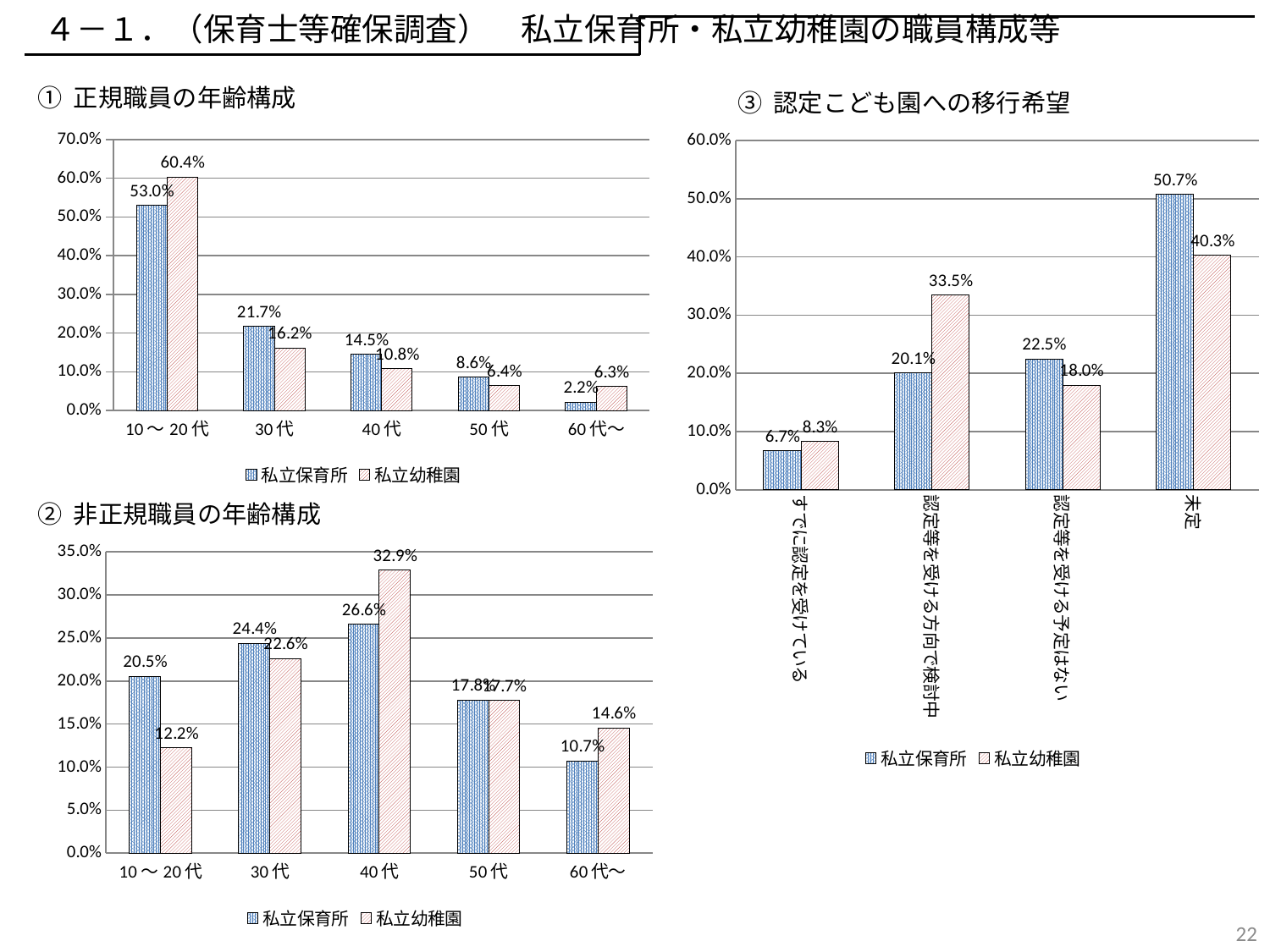
In the chart ① 正規職員の年齢構成, which age category has the highest value for 私立保育所? 10～20代 In the chart ③ 認定こども園への移行希望, what is the difference between 私立幼稚園 and 私立保育所 in the 認定等を受ける方向で検討中 category? 13.4% In the chart ③ 認定こども園への移行希望, what is the value for 私立保育所 in the 未定 category? 50.7% In the chart ① 正規職員の年齢構成, what is the value for 私立保育所 in the 60代～ category? 2.2% In the chart ② 非正規職員の年齢構成, what is the value for 私立幼稚園 in the 40代 category? 32.9% In the chart ③ 認定こども園への移行希望, how many series does the legend list? 2 In the chart ② 非正規職員の年齢構成, which is larger in the 10～20代 category, 私立保育所 or 私立幼稚園? 私立保育所 In the chart ① 正規職員の年齢構成, what is the difference between 私立保育所 and 私立幼稚園 in the 30代 category? 5.5% In the chart ① 正規職員の年齢構成, what is the value for 私立幼稚園 in the 10～20代 category? 60.4% What kind of chart is the chart ③ 認定こども園への移行希望? Bar chart In the chart ② 非正規職員の年齢構成, which age category has the lowest value for 私立保育所? 60代～ In the chart ② 非正規職員の年齢構成, how many age categories are shown on the x axis? 5